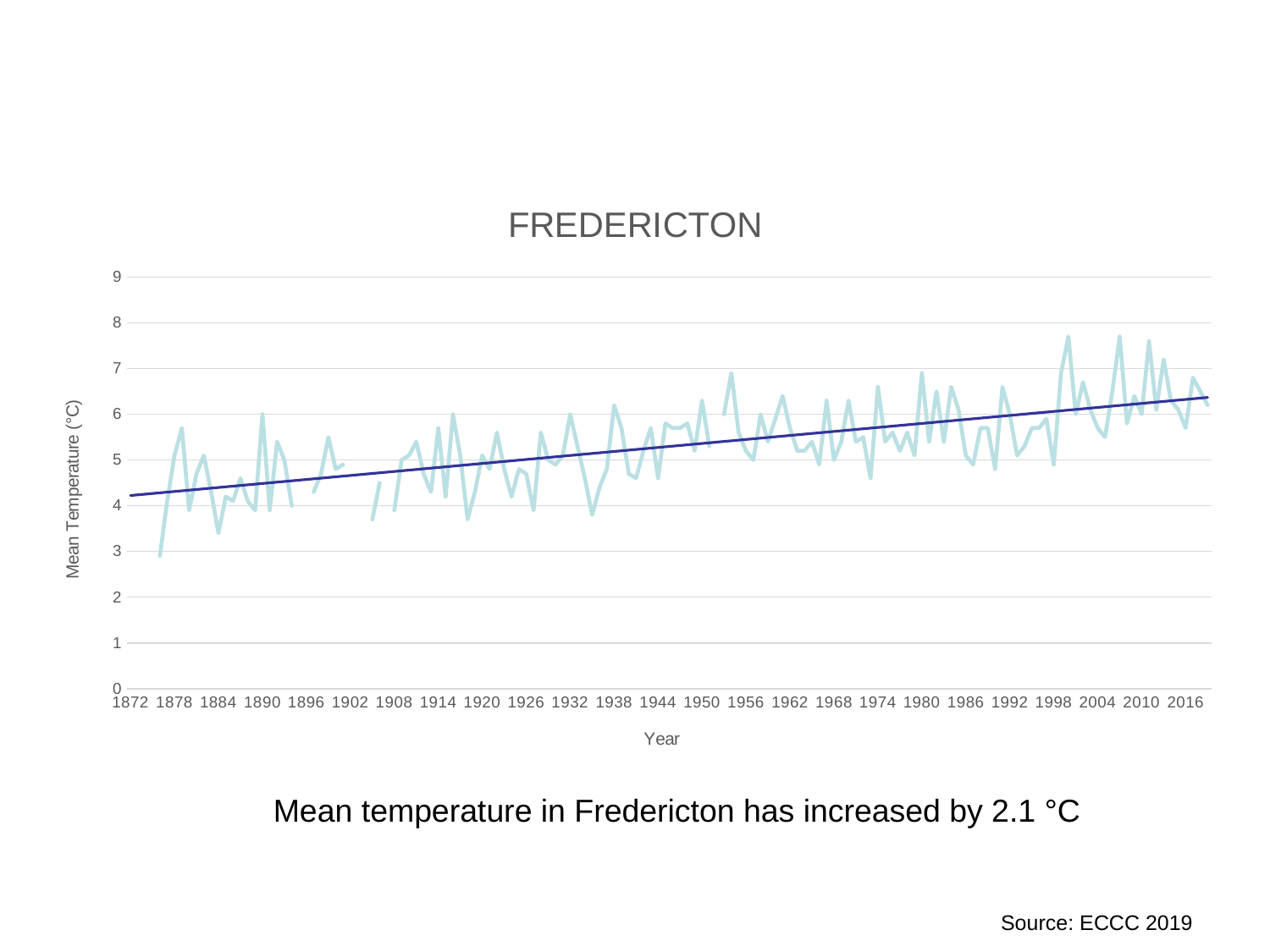
Is the lowest mean temperature plotted on the chart greater or less than 4? less Is the value of the trend line at 2016 greater or less than 8? less Is the value of the trend line at 1872 greater or less than 5? less Does the trend line rise or fall from 1872 to 2016? rises What is the title of the chart? FREDERICTON What is the label on the vertical axis of the chart? Mean Temperature (°C) What kind of chart is shown on the slide? line chart